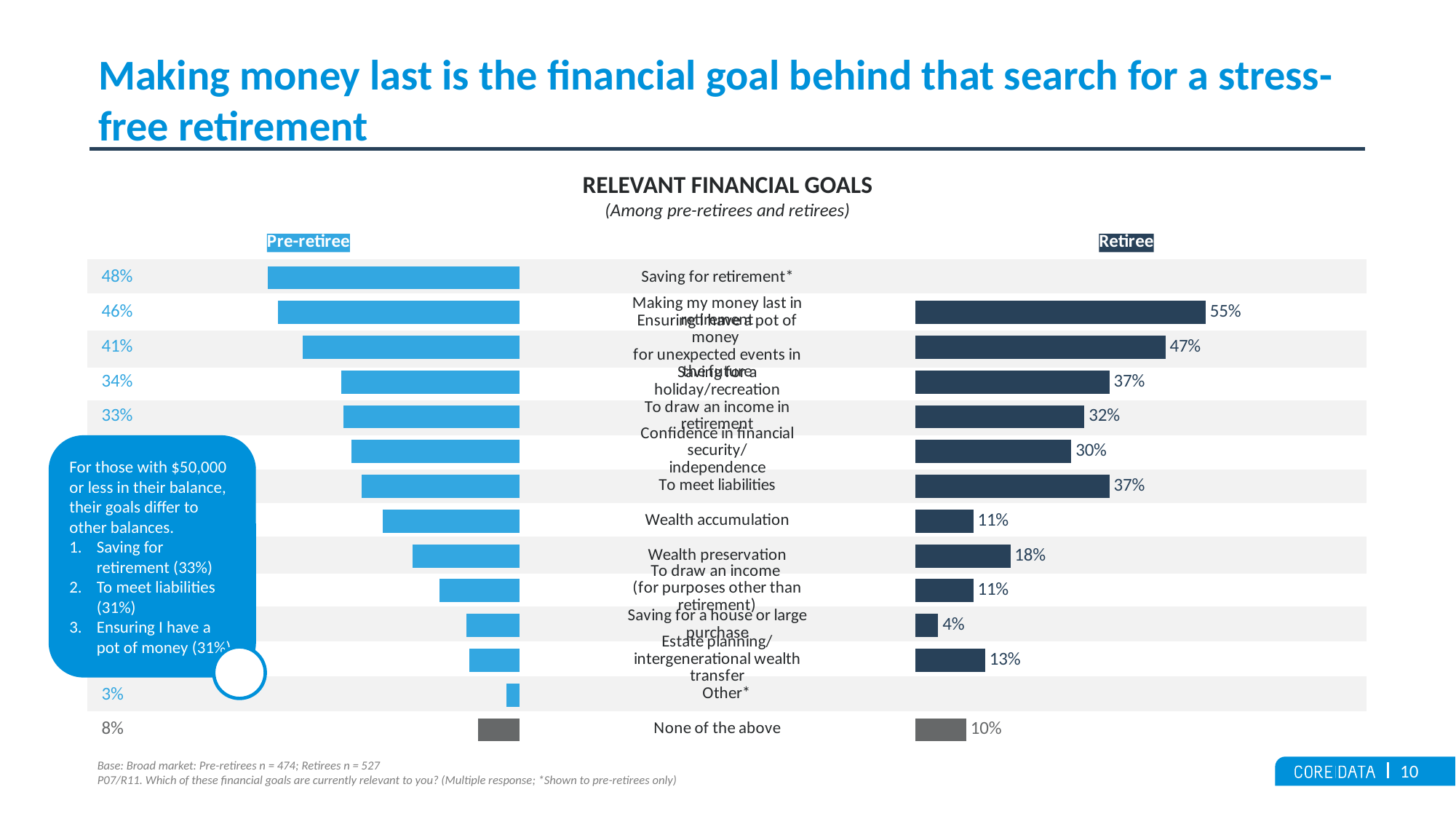
Which financial goal has the lowest Retiree value (excluding None of the above)? Saving for a house or large purchase What is the difference between the Retiree values for Wealth preservation and Wealth accumulation? 7 percentage points What is the Retiree value for Wealth accumulation? 11% Which has the larger Retiree value: To meet liabilities or Wealth preservation? To meet liabilities What is the Pre-retiree value for None of the above? 8% Which financial goal has the highest Retiree value? Making my money last in retirement How many series does the chart show? 2 What is the Retiree value for Wealth preservation? 18% What is the Retiree value for Saving for a house or large purchase? 4% What is the Retiree value for To meet liabilities? 37% What kind of chart is shown on the slide? Bar chart What is the Pre-retiree value for Saving for retirement*? 48%